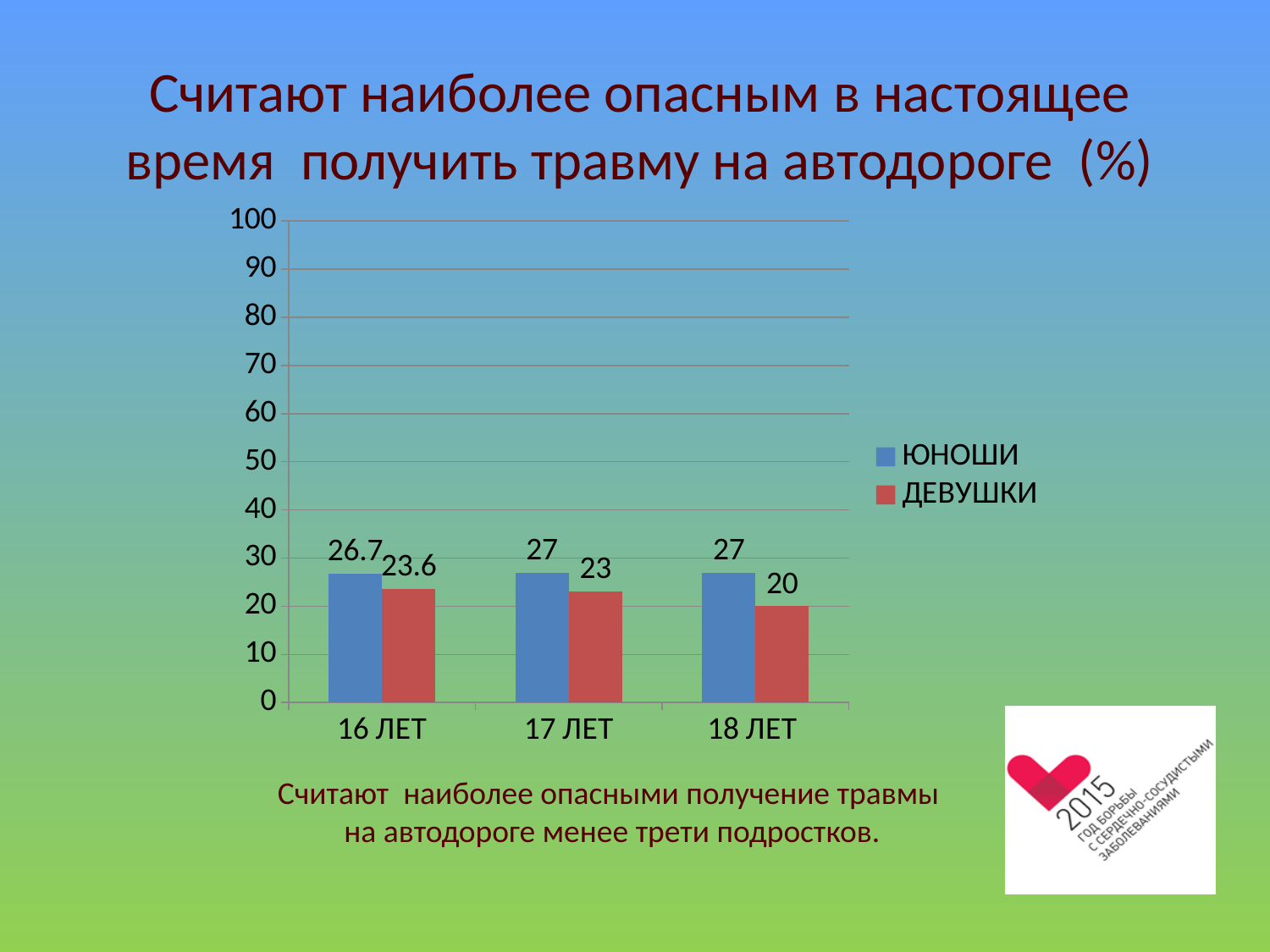
What is the value for ДЕВУШКИ at 17 ЛЕТ? 23 What is the value for ДЕВУШКИ at 18 ЛЕТ? 20 Which age group has the lowest value for ДЕВУШКИ? 18 ЛЕТ What is the value for ЮНОШИ at 16 ЛЕТ? 26.7 How many series does the legend list? 2 What is the difference between ЮНОШИ and ДЕВУШКИ at 18 ЛЕТ? 7 Is the value for ЮНОШИ at 17 ЛЕТ greater or less than 30? less What kind of chart is shown on the slide? bar chart Which age group has the highest value for ДЕВУШКИ? 16 ЛЕТ Which is larger at 17 ЛЕТ: ЮНОШИ or ДЕВУШКИ? ЮНОШИ How many age categories are shown on the x axis? 3 What is the difference between ЮНОШИ and ДЕВУШКИ at 16 ЛЕТ? 3.1